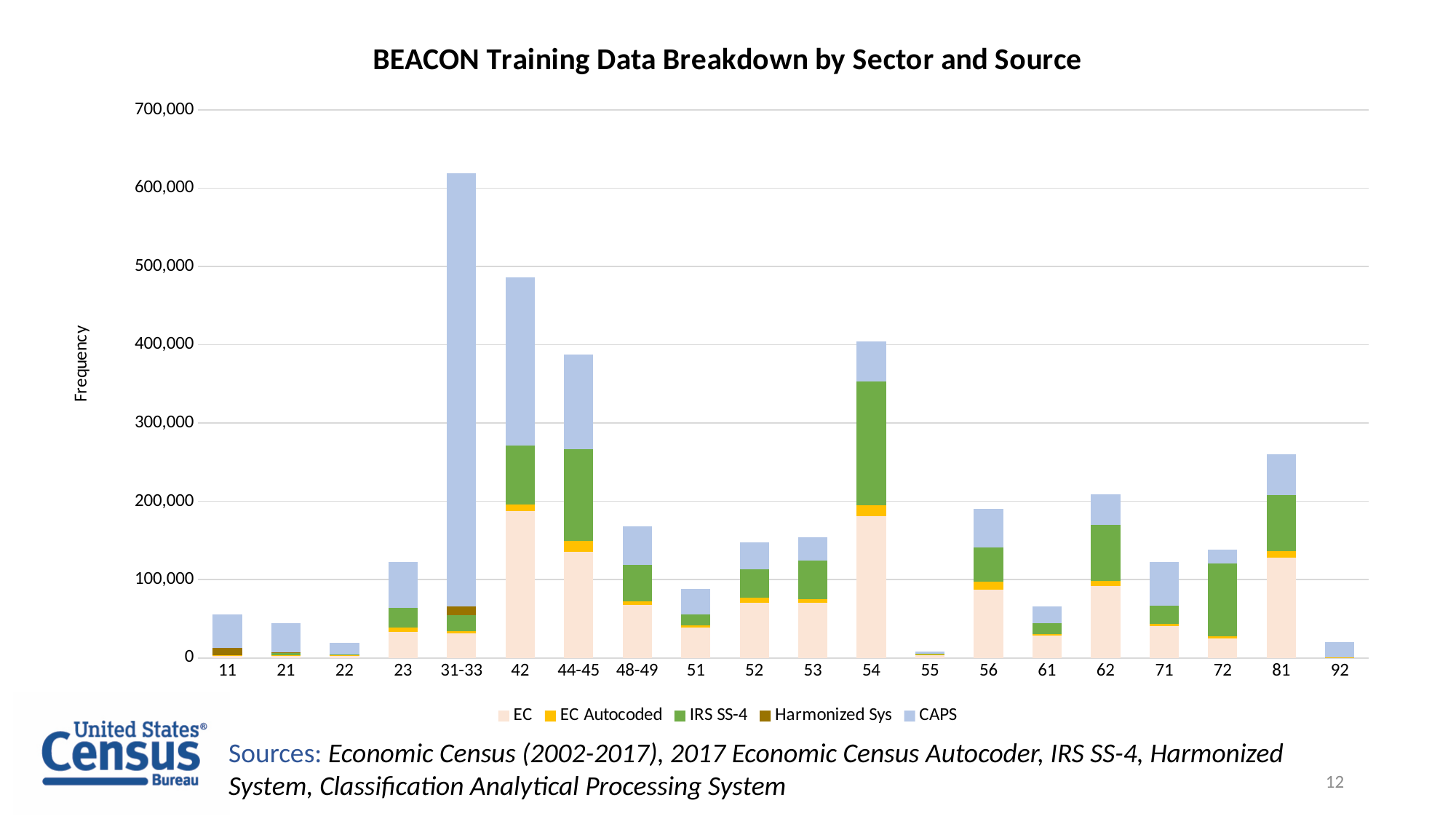
How many sector categories are shown along the x axis? 20 Is the total value for sector 54 greater or less than 300,000? greater How many series does the legend list? 5 Is the total value for sector 31-33 greater or less than 600,000? greater Which sector has the lowest total frequency? 55 Is the total value for sector 42 greater or less than 500,000? less What kind of chart is shown on the slide? Stacked bar chart What is the title of the chart? BEACON Training Data Breakdown by Sector and Source Which sector has the highest total frequency? 31-33 Which sector has a larger total frequency, 54 or 81? 54 Which sector has a larger total frequency, 42 or 44-45? 42